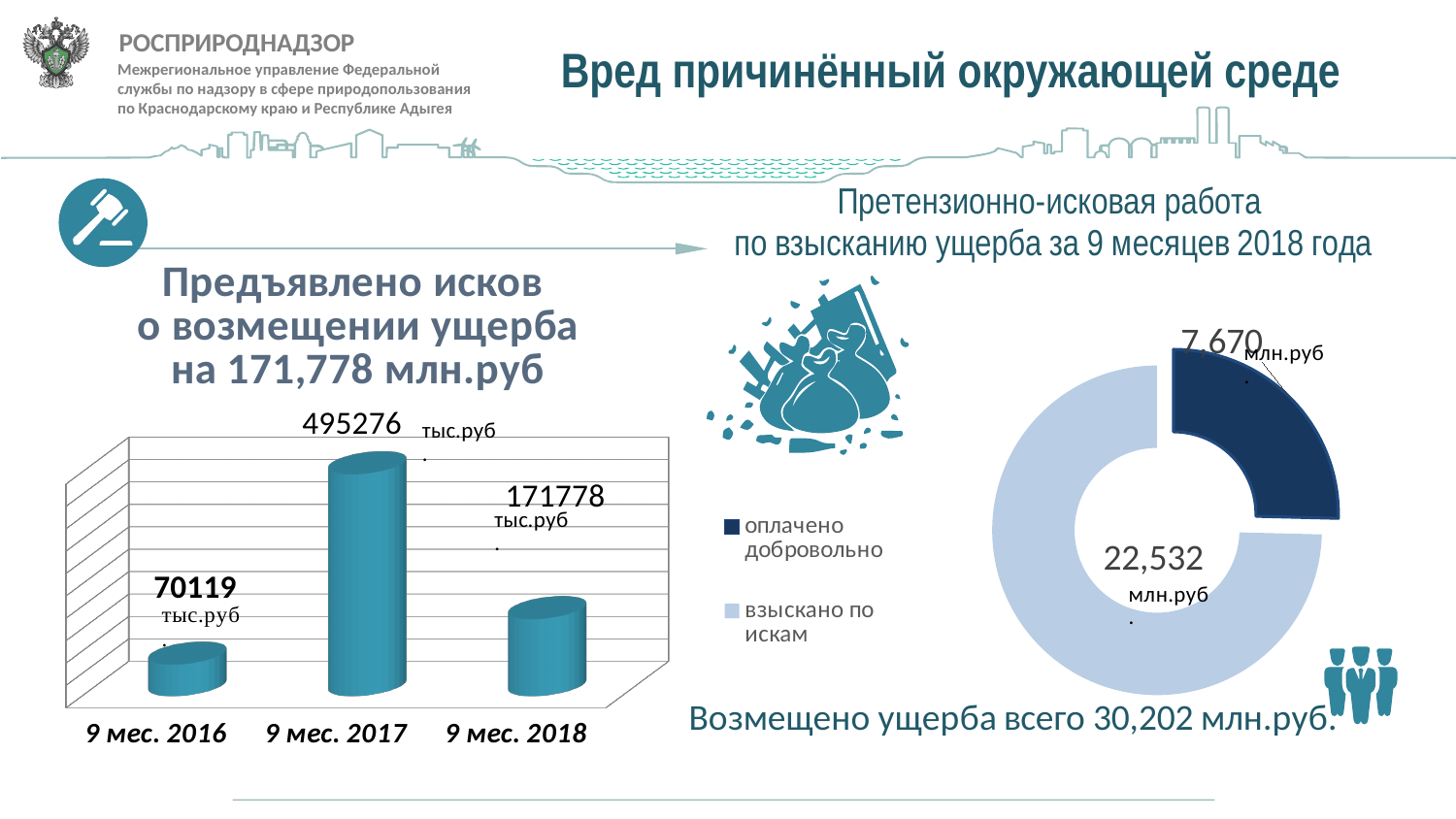
In the doughnut chart on the right, how many entries does the legend list? 2 In the bar chart on the left, which period has the lowest value? 9 мес. 2016 In the bar chart on the left, what is the value for 9 мес. 2016? 70119 тыс.руб In the bar chart on the left, what is the value for 9 мес. 2018? 171778 тыс.руб In the bar chart on the left, what is the value for 9 мес. 2017? 495276 тыс.руб What kind of chart is the one on the left of the slide? Bar chart In the bar chart on the left, which period has the highest value? 9 мес. 2017 In the doughnut chart on the right, what is the value for взыскано по искам? 22,532 млн.руб In the doughnut chart on the right, what is the value for оплачено добровольно? 7,670 млн.руб In the bar chart on the left, how many periods are shown? 3 In the doughnut chart on the right, which is larger: оплачено добровольно or взыскано по искам? взыскано по искам In the bar chart on the left, what is the difference between the values for 9 мес. 2017 and 9 мес. 2018? 323498 тыс.руб